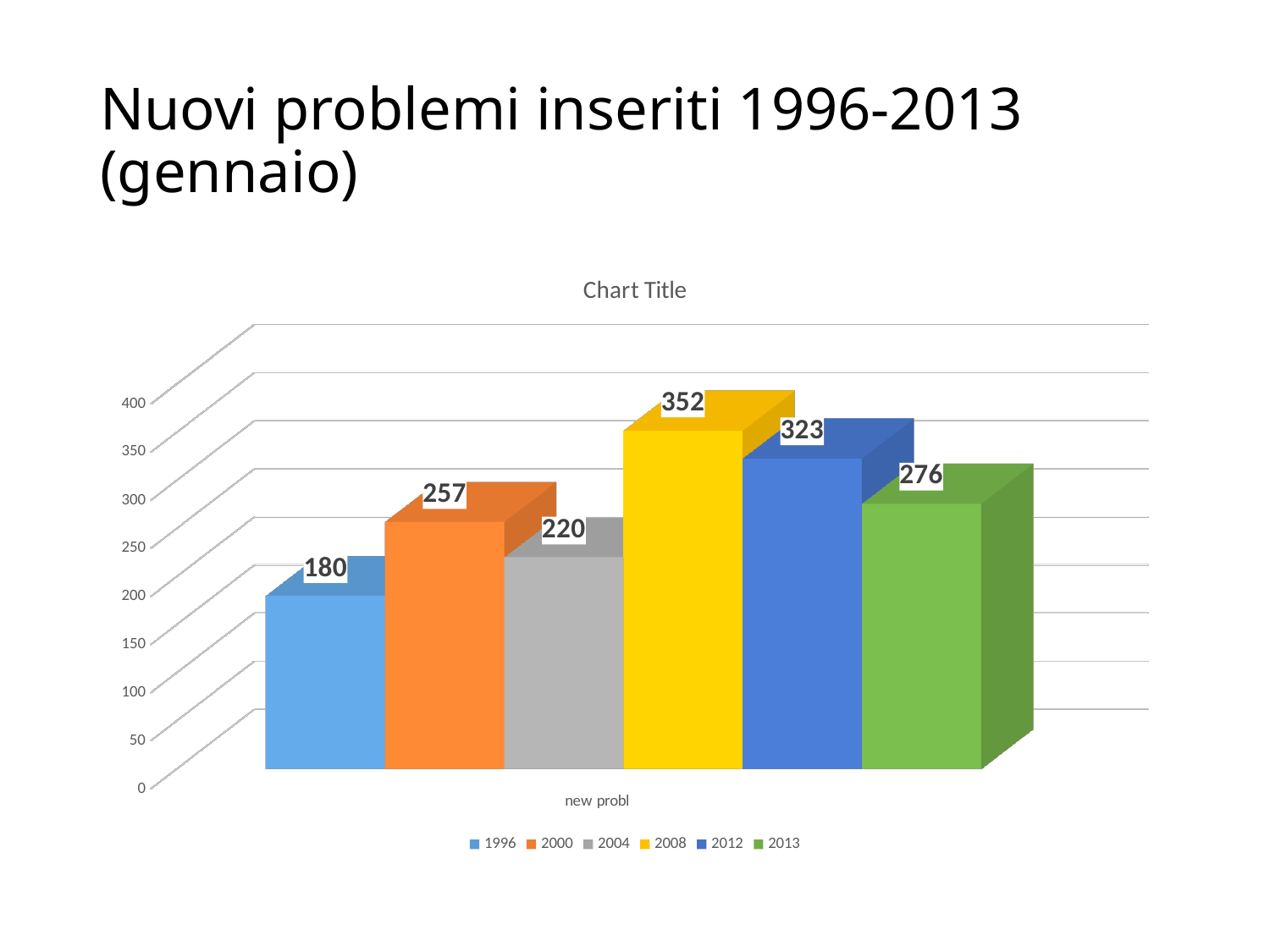
What is the difference between the values for 2000 and 1996? 77 What is the value for 2008? 352 What colour is the bar for 2008? yellow How many series does the legend list? 6 What kind of chart is shown? bar chart What is the value for 1996? 180 Which year has the highest value? 2008 Which is larger, the value for 2004 or the value for 2013? 2013 What is the category label on the x axis? new probl What is the value for 2013? 276 What is the difference between the values for 2008 and 2012? 29 Which year has the lowest value? 1996